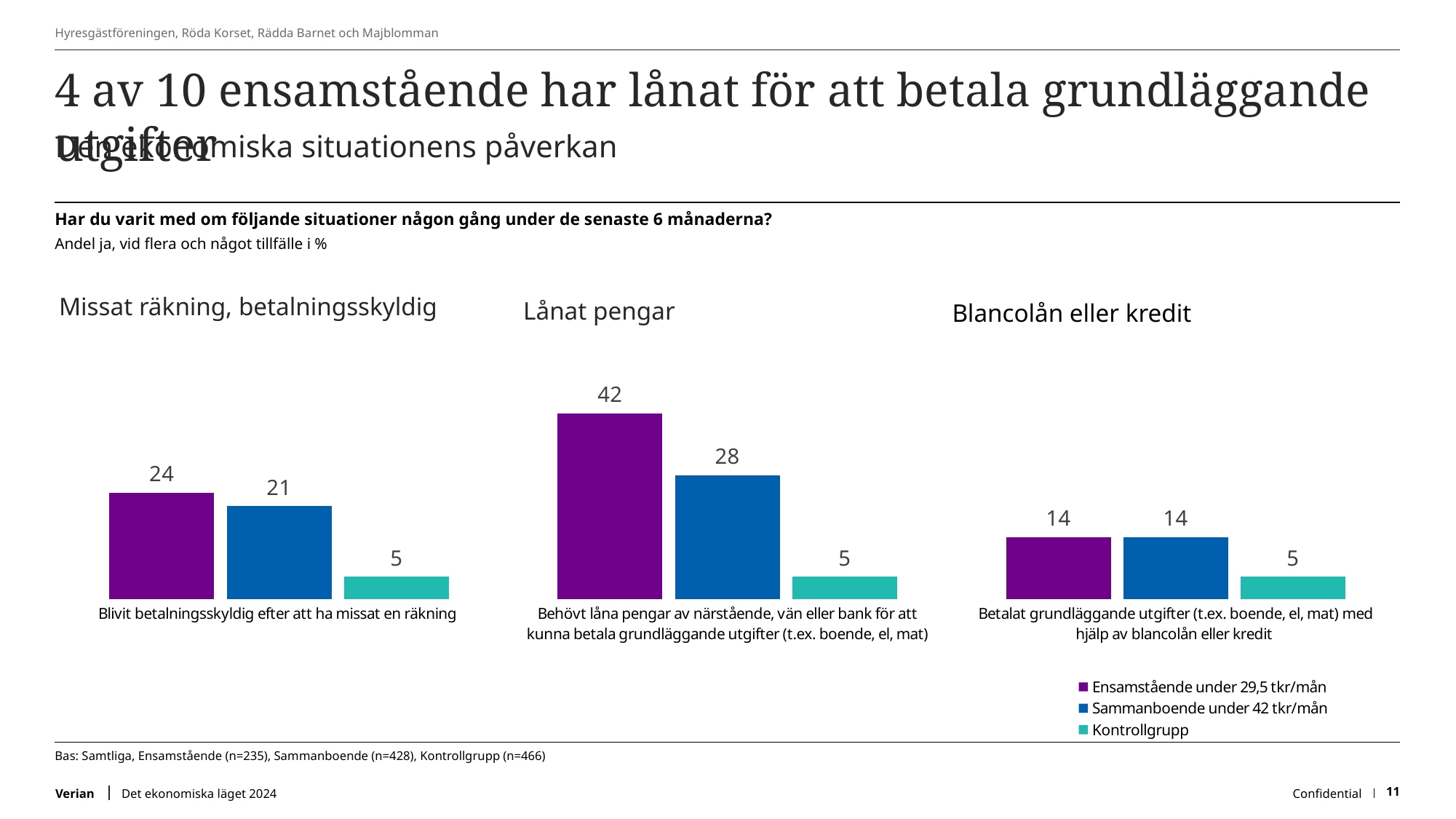
In the 'Lånat pengar' chart, what is the value for Ensamstående under 29,5 tkr/mån? 42 In the 'Missat räkning, betalningsskyldig' chart, what is the value for Sammanboende under 42 tkr/mån? 21 How many charts are shown on the slide? 3 In the 'Lånat pengar' chart, what is the difference between the values for Ensamstående under 29,5 tkr/mån and Sammanboende under 42 tkr/mån? 14 What kind of chart is the 'Lånat pengar' chart? Bar chart In the 'Blancolån eller kredit' chart, what is the value for Sammanboende under 42 tkr/mån? 14 How many series does the legend list? 3 In the 'Lånat pengar' chart, which group has the highest value? Ensamstående under 29,5 tkr/mån In the 'Lånat pengar' chart, which is larger: the value for Sammanboende under 42 tkr/mån or the value for Kontrollgrupp? Sammanboende under 42 tkr/mån In the 'Missat räkning, betalningsskyldig' chart, what is the difference between the values for Ensamstående under 29,5 tkr/mån and Kontrollgrupp? 19 In the 'Blancolån eller kredit' chart, what is the value for Kontrollgrupp? 5 In the 'Missat räkning, betalningsskyldig' chart, which group has the lowest value? Kontrollgrupp